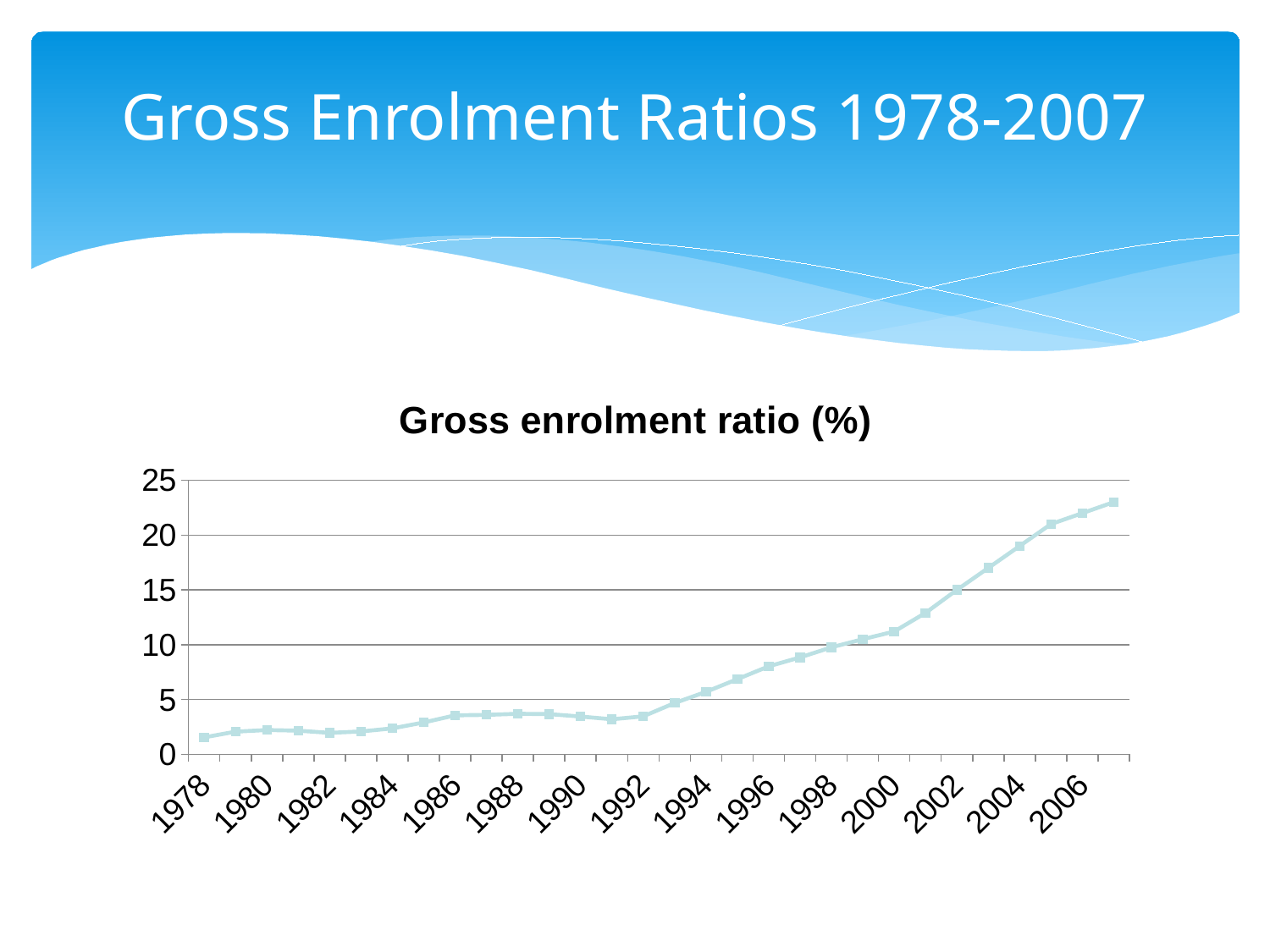
Which year has the highest gross enrolment ratio? 2007 What kind of chart is shown on the slide? line chart Do the values generally rise or fall from 1978 to 2007? rise Is the value for 1990 greater or less than 5? less Is the value for 1978 greater or less than 5? less Which year has the lowest gross enrolment ratio? 1978 Which year has the larger value, 1996 or 1988? 1996 Is the value for 2006 greater or less than 20? greater How many data points are plotted on the line? 30 What is the title of the chart? Gross enrolment ratio (%)